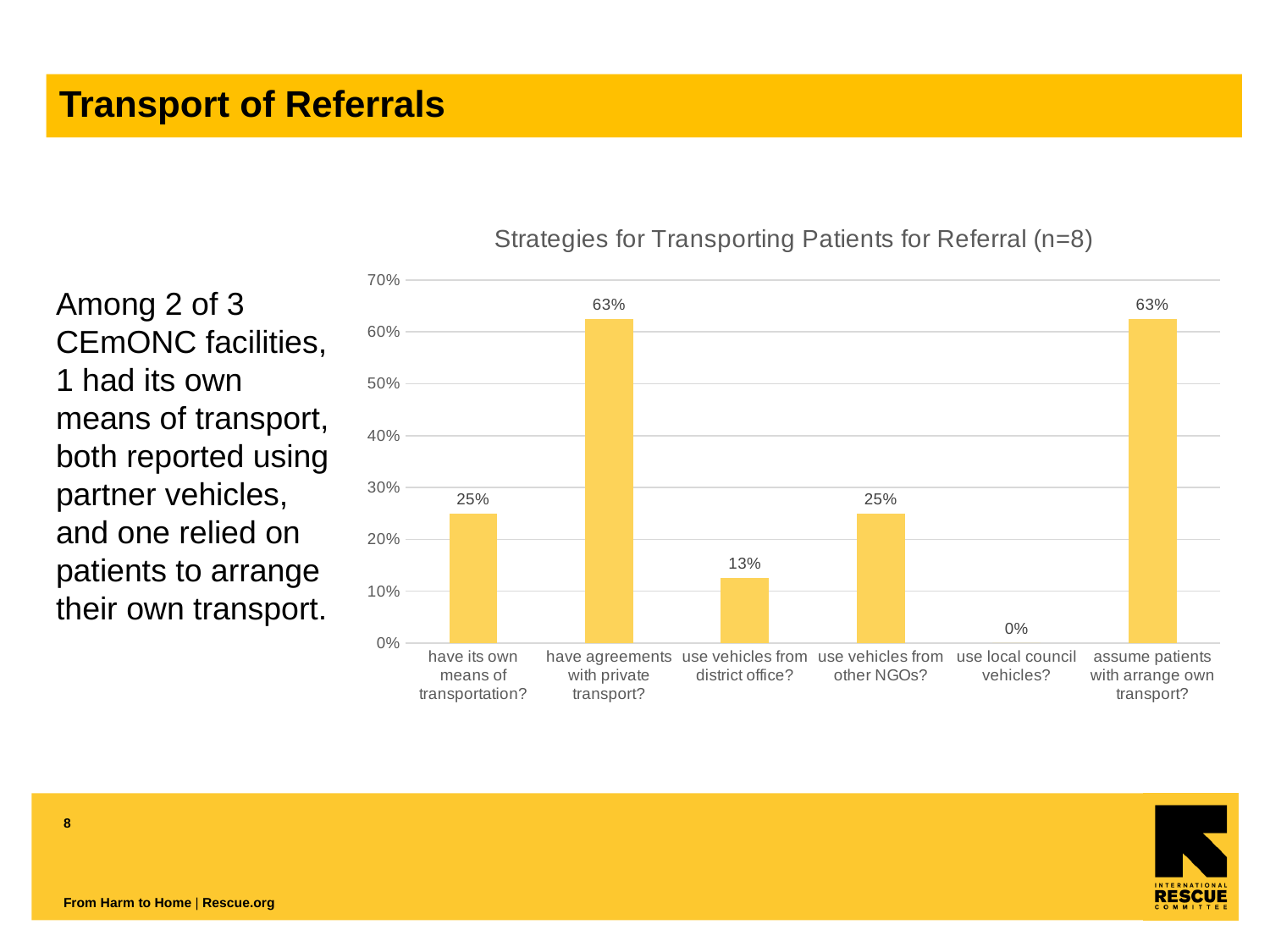
What is the value for 'use local council vehicles?'? 0% What kind of chart is this? bar chart What is the value for 'have its own means of transportation?'? 25% What is the value for 'have agreements with private transport?'? 63% What is the difference between 'have agreements with private transport?' and 'use vehicles from other NGOs?'? 38% How many categories are shown on the x axis? 6 What is the difference between 'use vehicles from other NGOs?' and 'use vehicles from district office?'? 12% Which is larger: 'assume patients with arrange own transport?' or 'have its own means of transportation?'? assume patients with arrange own transport? Which category has the lowest value? use local council vehicles? What is the value for 'use vehicles from district office?'? 13% Is the value for 'have agreements with private transport?' greater or less than 50%? greater What is the title of the chart? Strategies for Transporting Patients for Referral (n=8)